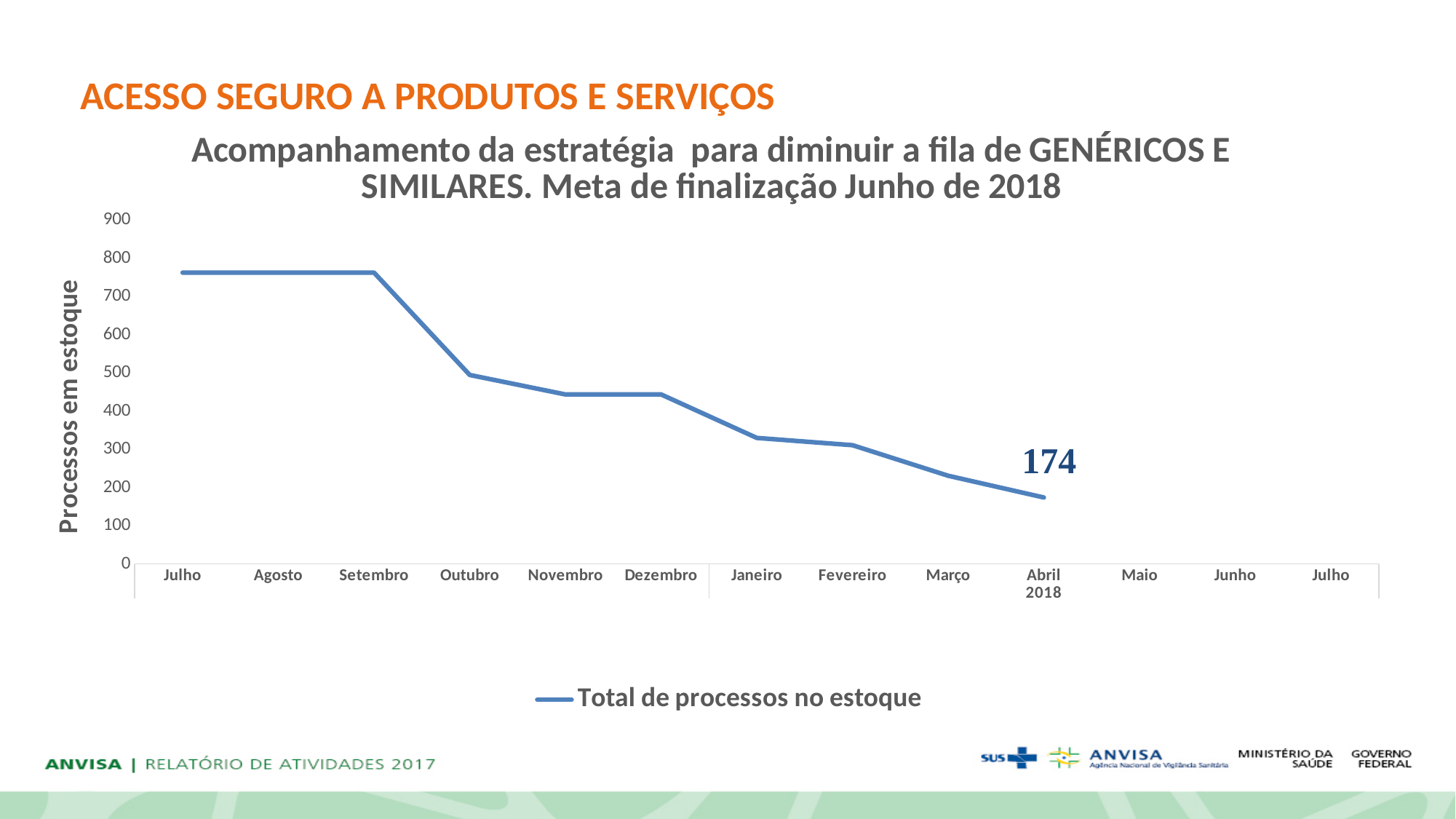
How many series does the legend list? 1 What kind of chart is shown on the slide? line chart Is the value for Julho greater or less than 700? greater What is the value for Abril 2018 on the line? 174 What is the name of the series shown in the legend? Total de processos no estoque Is the value for Novembro greater or less than 500? less What is the title of the vertical axis? Processos em estoque Is the value for Março greater or less than 300? less Which is larger, the value for Outubro or the value for Janeiro? Outubro How many months have a plotted data point on the line? 10 Do the values rise or fall from Julho to Abril 2018? fall Which month has the lowest plotted value? Abril 2018